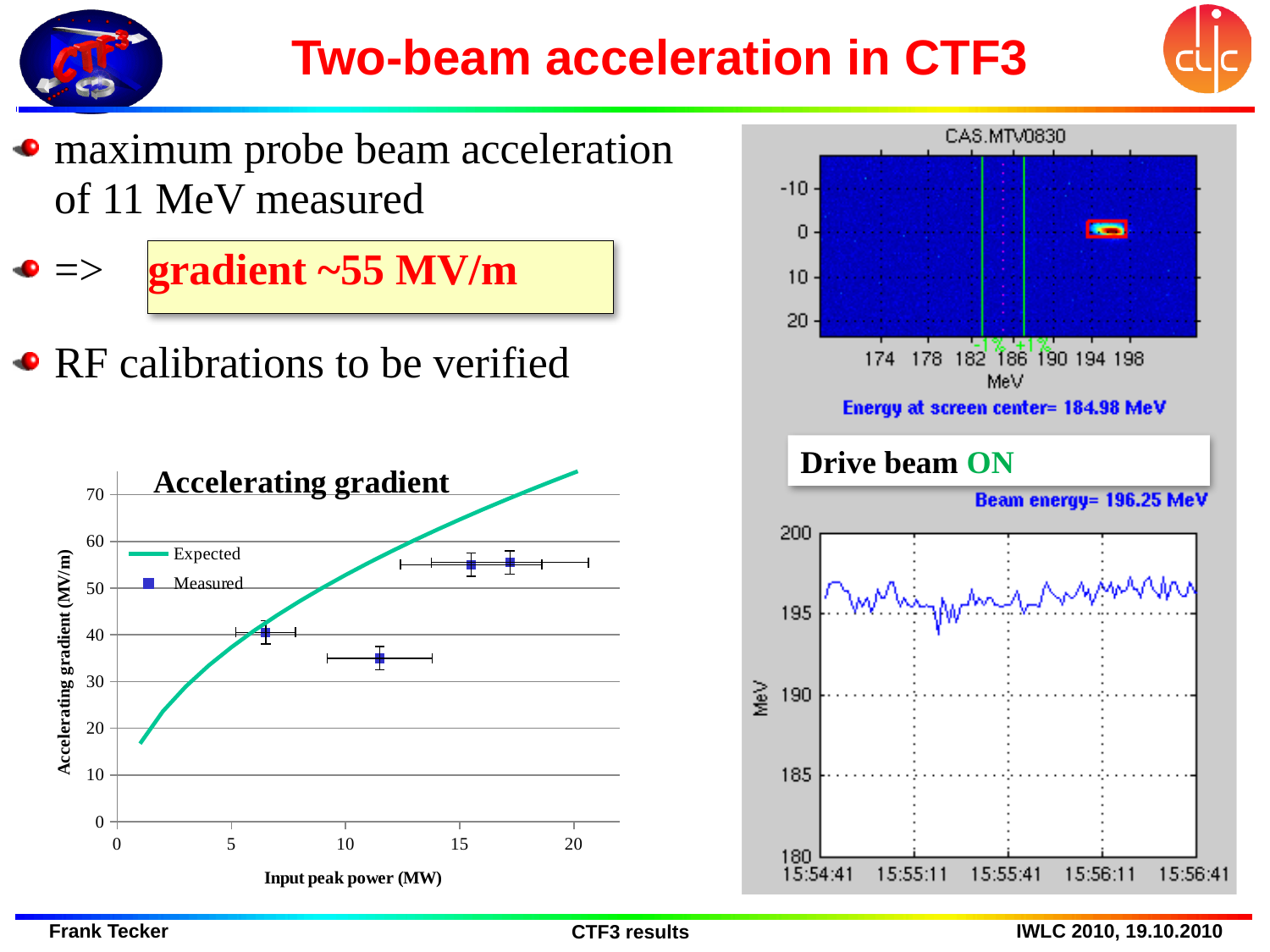
In the 'Accelerating gradient' chart, is the measured gradient at about 6.5 MW greater or less than 30? greater How many series does the legend of the 'Accelerating gradient' chart list? 2 In the 'Accelerating gradient' chart, which measured point has the higher gradient: the one at about 6.5 MW or the one at about 11.5 MW? the one at about 6.5 MW In the beam energy plot at the bottom right, what beam energy value is printed above the plot? 196.25 MeV In the 'Accelerating gradient' chart, are the measured gradients at about 15-17 MW greater or less than 50? greater What kind of chart is the 'Accelerating gradient' chart? line chart In the 'Accelerating gradient' chart, is the Expected curve at 20 MW greater or less than 70? greater What is the x-axis title of the 'Accelerating gradient' chart? Input peak power (MW) What are the two legend entries in the 'Accelerating gradient' chart? Expected and Measured How many measured data points are plotted in the 'Accelerating gradient' chart? 4 In the 'Accelerating gradient' chart, does the Expected curve rise or fall as input peak power increases? rises